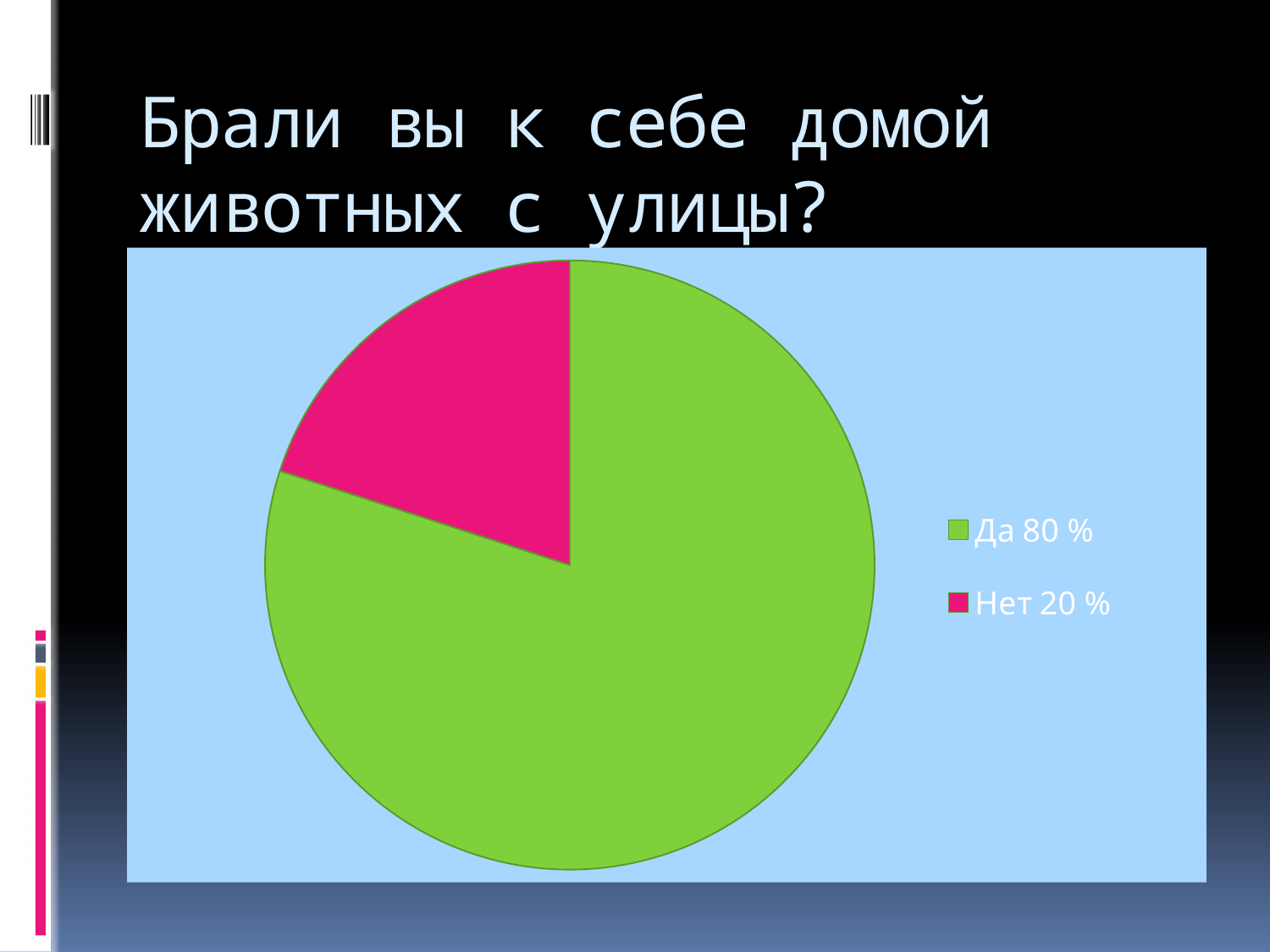
Which is larger, the slice for "Да" or the slice for "Нет"? Да What colour is the slice for "Нет"? pink What share of the pie does "Нет" take? 20 % What share of the pie does "Да" take? 80 % What is the title of the slide above the chart? Брали вы к себе домой животных с улицы? How many slices does the pie chart have? 2 What kind of chart is shown on the slide? pie chart What is the difference between the share for "Да" and the share for "Нет"? 60 % Which category has the smallest slice of the pie? Нет What is the value shown for "Да" in the legend? 80 % What is the value shown for "Нет" in the legend? 20 % Which category has the largest slice of the pie? Да